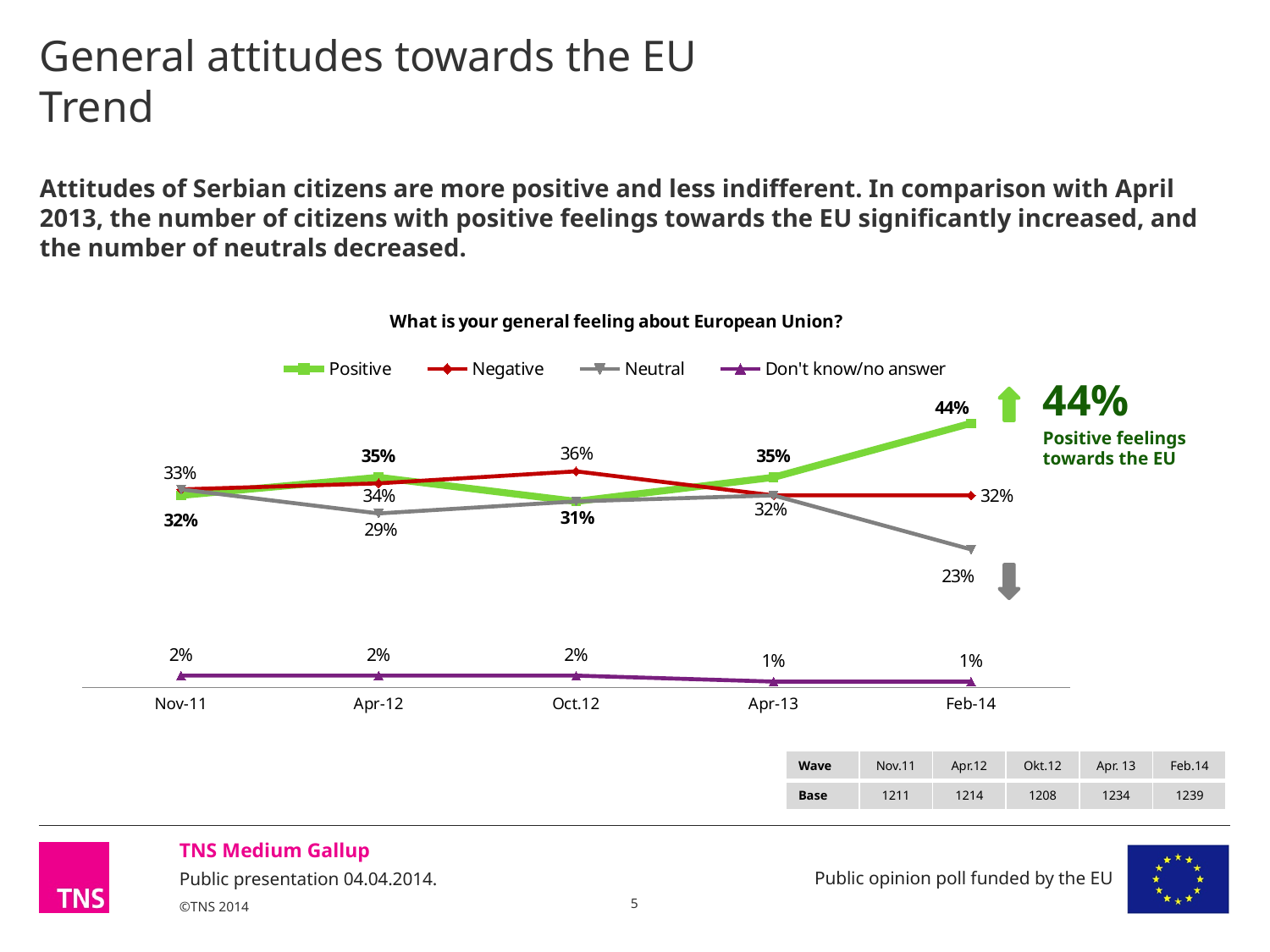
What is the value for Neutral in Apr-12? 29% What is the value for Negative in Oct.12? 36% How many series does the legend list? 4 What is the value for Positive in Feb-14? 44% How many waves (points along the x axis) are plotted? 5 In Feb-14, which is larger, Positive or Negative? Positive In which wave is the Positive series highest? Feb-14 By how many percentage points did Positive change from Apr-13 to Feb-14? 9 percentage points What kind of chart is shown on the slide? line chart What is the value for Don't know/no answer in Apr-13? 1% What is the title of the chart? What is your general feeling about European Union? What is the value for Neutral in Feb-14? 23%